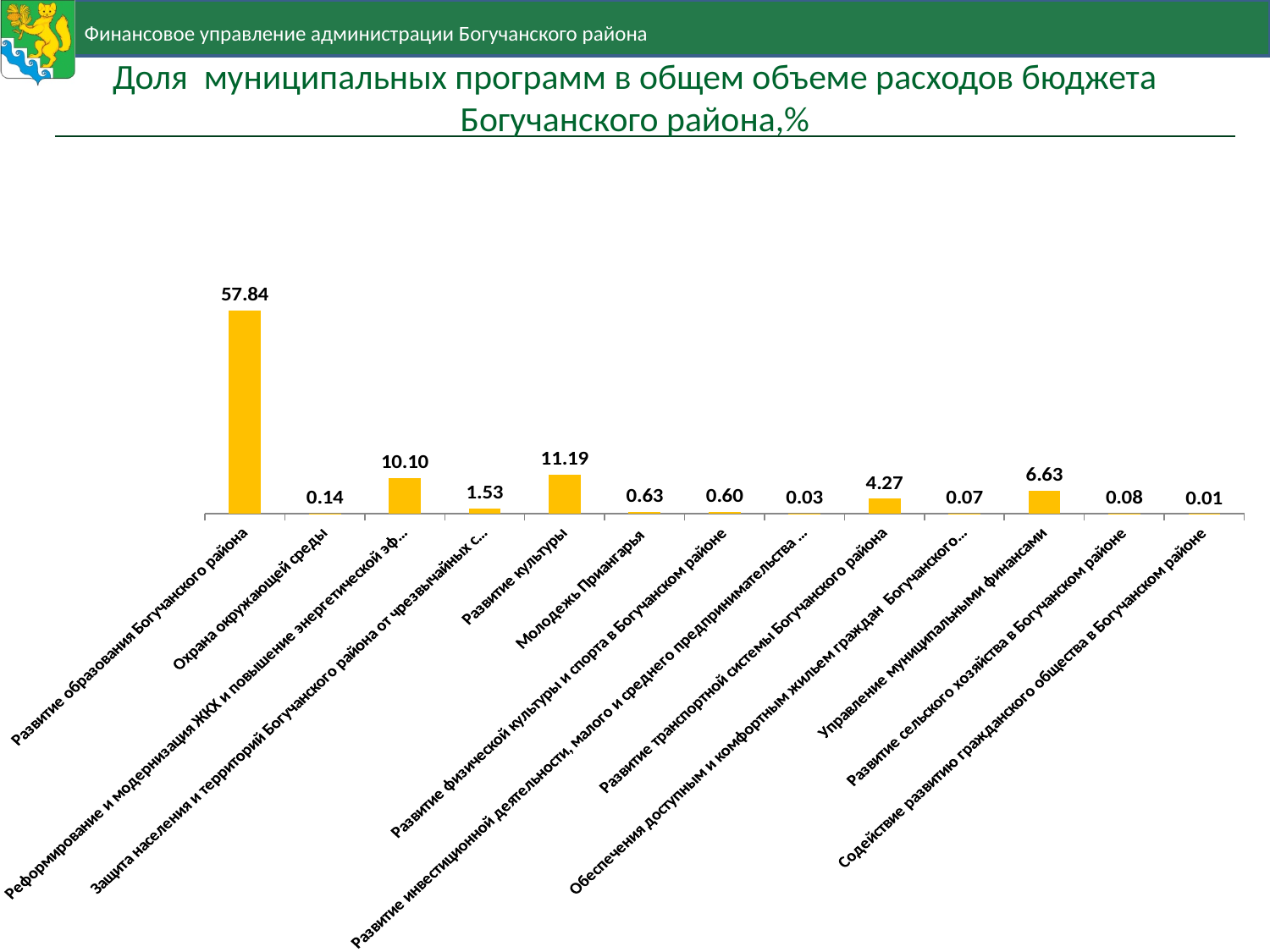
What is the value for Развитие транспортной системы Богучанского района? 4.27 What kind of chart is shown on the slide? Bar chart Which category has the highest value? Развитие образования Богучанского района What is the value for Развитие образования Богучанского района? 57.84 Which is larger: the value for Развитие культуры or the value for Управление муниципальными финансами? Развитие культуры What is the value for Развитие культуры? 11.19 How many categories are shown in the chart? 13 What is the difference between the values for Развитие культуры and Реформирование и модернизация ЖКХ и повышение энергетической эф...? 1.09 What is the value for Управление муниципальными финансами? 6.63 Which category has the lowest value? Содействие развитию гражданского общества в Богучанском районе What is the title of the chart? Доля муниципальных программ в общем объеме расходов бюджета Богучанского района,% What is the value for Молодежь Приангарья? 0.63